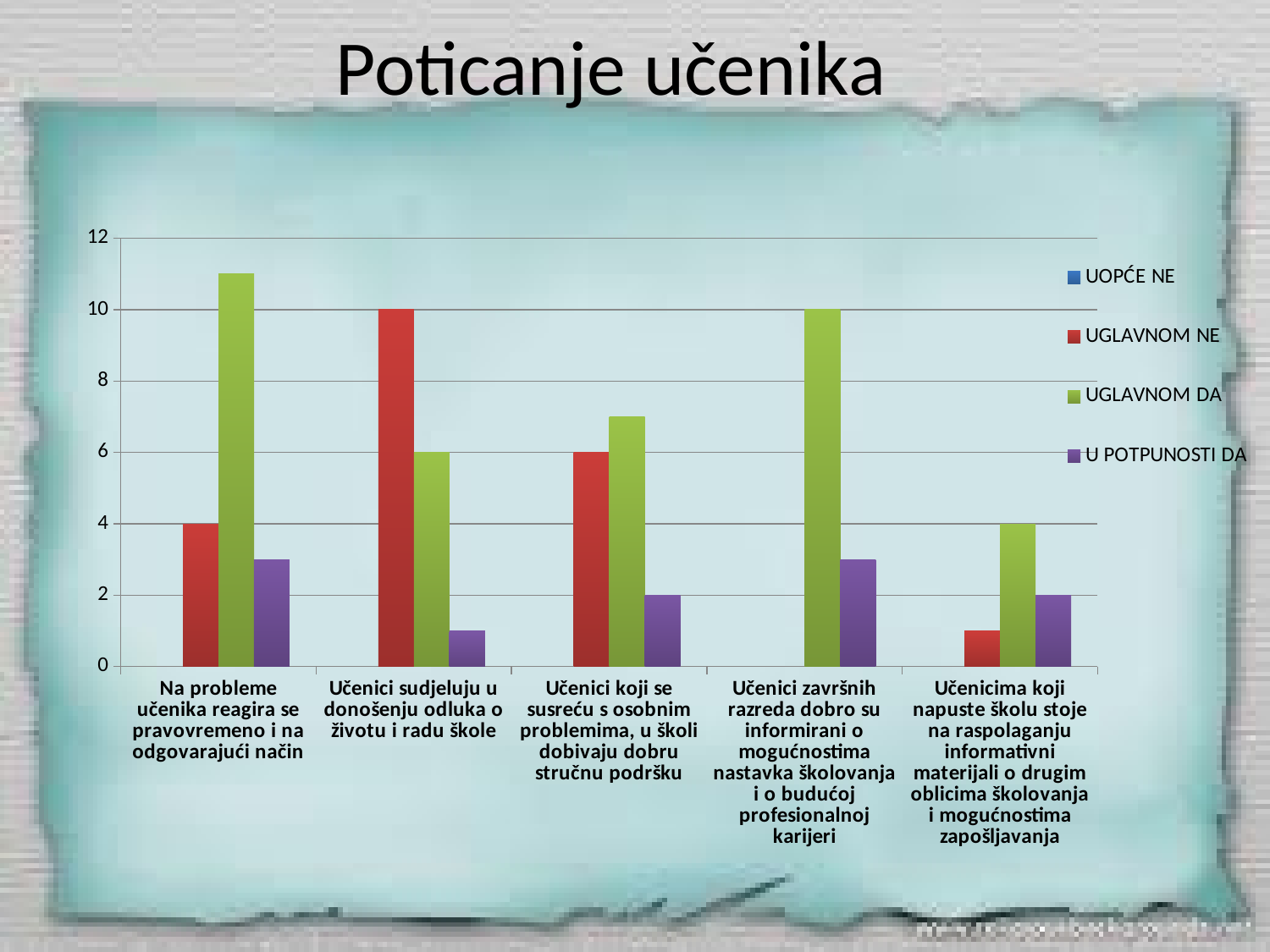
Is the value of U POTPUNOSTI DA for 'Učenici sudjeluju u donošenju odluka o životu i radu škole' greater or less than 2? less What is the value of UGLAVNOM DA for 'Učenici završnih razreda dobro su informirani o mogućnostima nastavka školovanja i o budućoj profesionalnoj karijeri'? 10 What is the value of UGLAVNOM NE for 'Na probleme učenika reagira se pravovremeno i na odgovarajući način'? 4 What is the difference between UGLAVNOM NE and UGLAVNOM DA for 'Učenici sudjeluju u donošenju odluka o životu i radu škole'? 4 How many series does the legend list? 4 How many categories are shown on the x axis? 5 Is the value of UGLAVNOM DA for 'Na probleme učenika reagira se pravovremeno i na odgovarajući način' greater or less than 10? greater What type of chart is shown on the slide? bar chart For 'Učenici koji se susreću s osobnim problemima, u školi dobivaju dobru stručnu podršku', which is larger: UGLAVNOM NE or UGLAVNOM DA? UGLAVNOM DA Which category has the highest UGLAVNOM DA value? Na probleme učenika reagira se pravovremeno i na odgovarajući način What is the value of UGLAVNOM NE for 'Učenici sudjeluju u donošenju odluka o životu i radu škole'? 10 What is the value of UGLAVNOM DA for 'Učenicima koji napuste školu stoje na raspolaganju informativni materijali o drugim oblicima školovanja i mogućnostima zapošljavanja'? 4